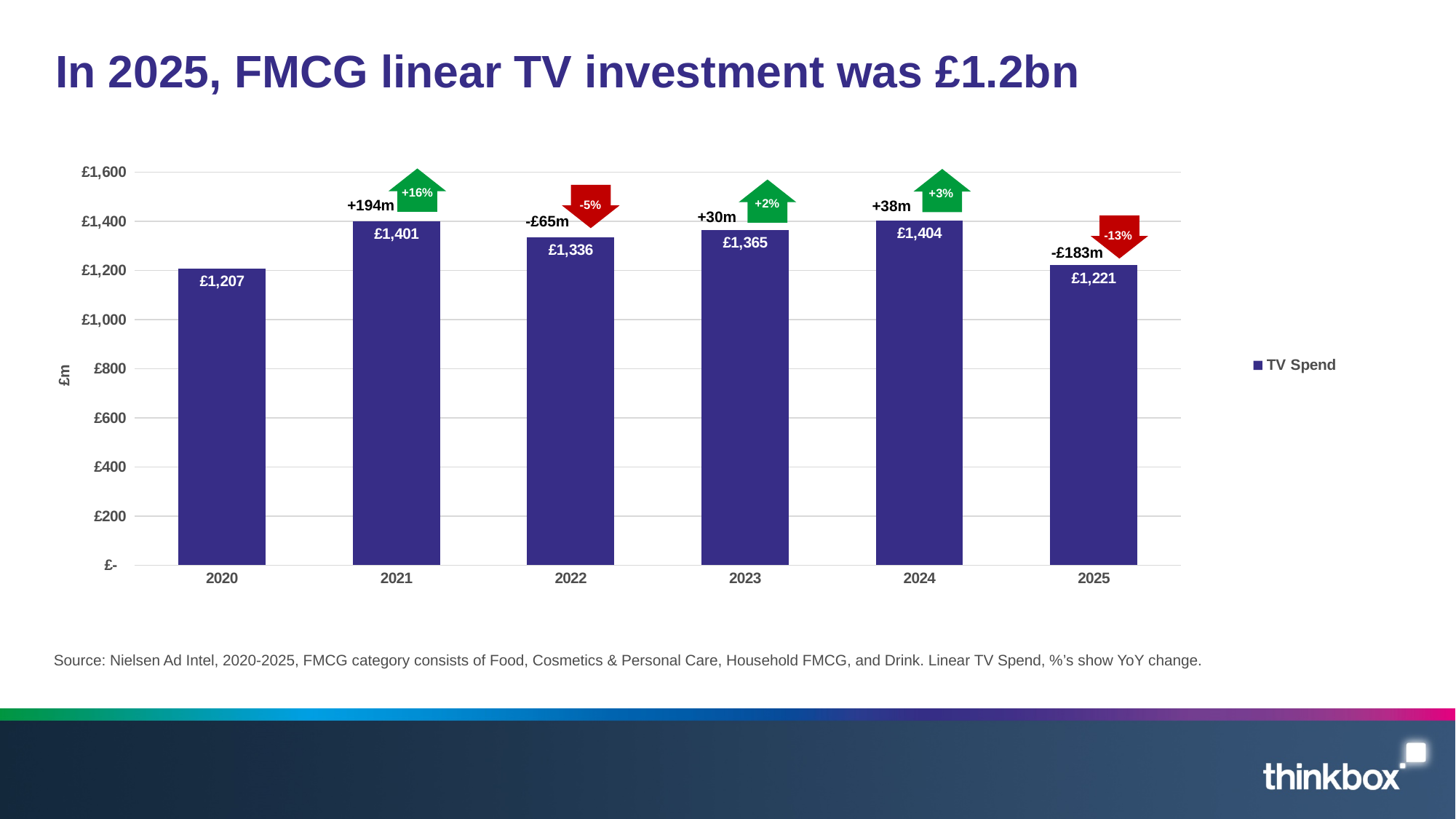
What was the TV Spend in 2023? £1,365 Is the TV Spend for 2024 greater or less than £1,200? greater What kind of chart is shown on the slide? Bar chart What was the TV Spend in 2022? £1,336 Which year had the larger TV Spend, 2021 or 2025? 2021 What is the year-on-year change in £m shown for 2025? -£183m What was the TV Spend in 2025? £1,221 How many years are shown on the x axis? 6 What series does the legend list? TV Spend What is the difference between the TV Spend in 2021 and in 2020? £194m What was the TV Spend in 2020? £1,207 What is the year-on-year percentage change shown for 2021? +16%